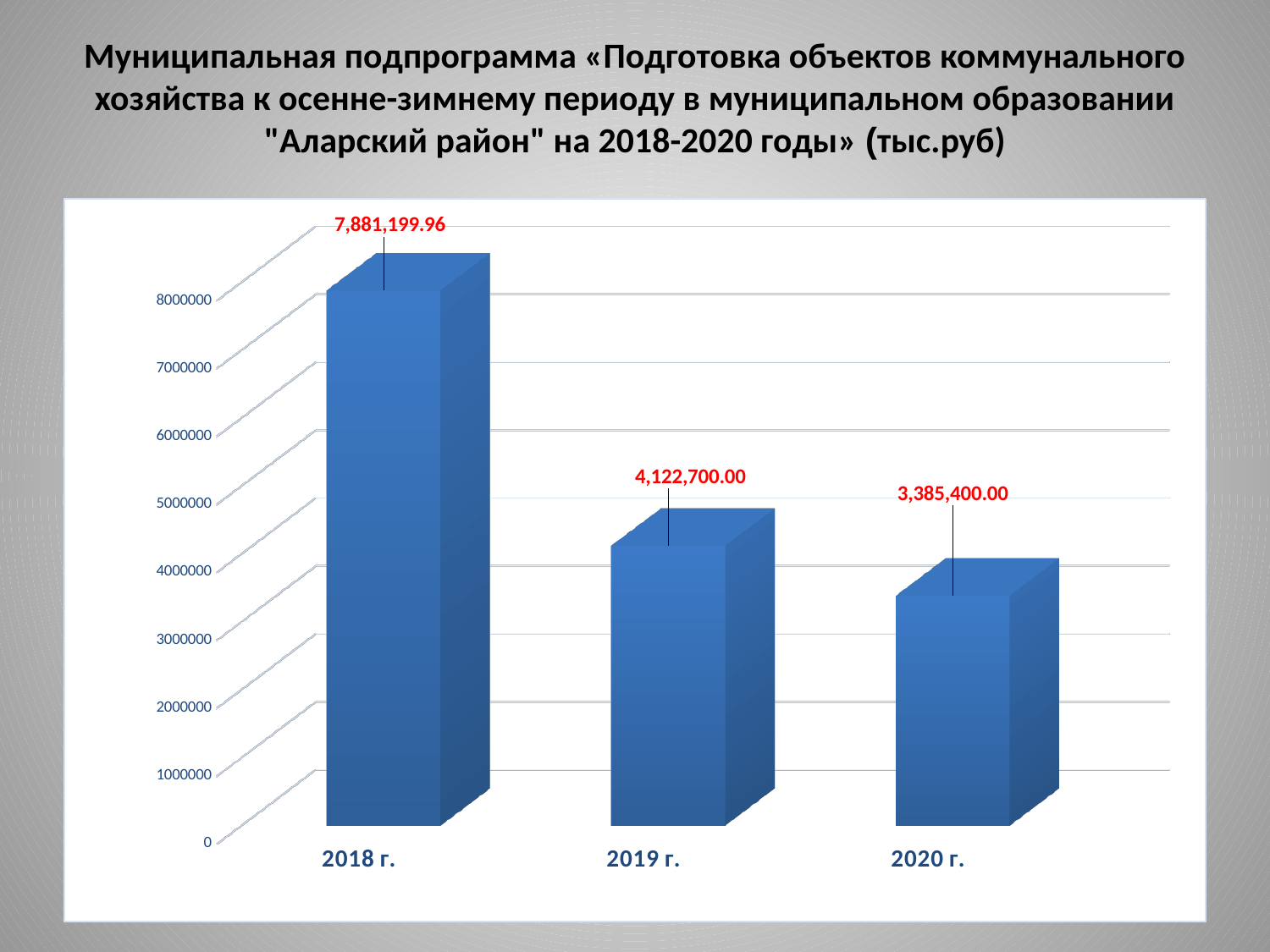
What is the difference between the values for 2019 г. and 2020 г.? 737,300.00 What is the value for 2018 г.? 7,881,199.96 What is the value for 2019 г.? 4,122,700.00 Do the values rise or fall from 2018 г. to 2020 г.? fall What is the difference between the values for 2018 г. and 2019 г.? 3,758,499.96 Which is larger, the value for 2019 г. or the value for 2020 г.? 2019 г. Which year has the highest value? 2018 г. How many years are shown on the chart? 3 What kind of chart is shown on the slide? bar chart Which year has the lowest value? 2020 г. Is the value for 2020 г. greater or less than 4000000? less What is the value for 2020 г.? 3,385,400.00